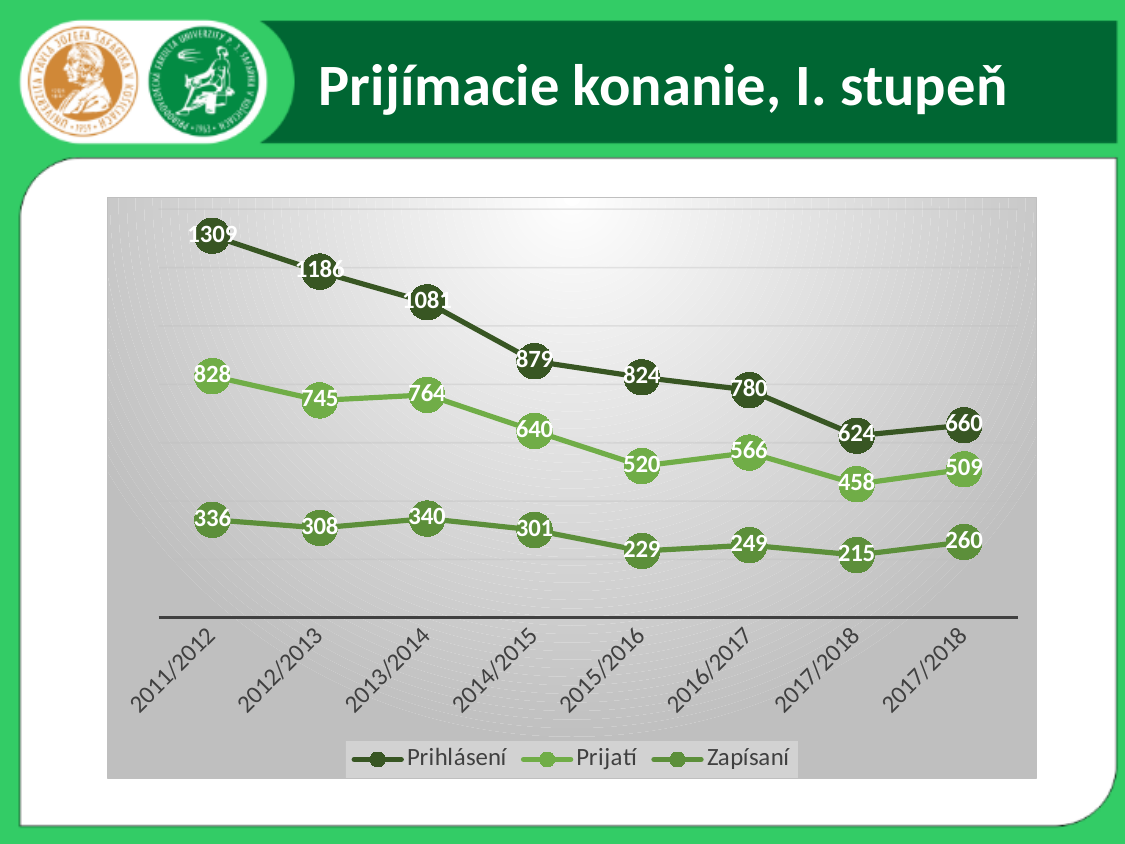
What is the difference between Prihlásení and Prijatí in 2012/2013? 441 In which year is the Prihlásení value highest? 2011/2012 How many data points does each series have? 8 How many series does the legend list? 3 Which is larger, the Prijatí value in 2013/2014 or in 2012/2013? 2013/2014 What is the value for Prihlásení in 2011/2012? 1309 What is the value for Zapísaní in 2015/2016? 229 What type of chart is shown on the slide? line chart Does the Prihlásení series generally rise or fall from 2011/2012 to 2016/2017? fall What is the value for Prijatí in 2014/2015? 640 What is the title of the slide? Prijímacie konanie, I. stupeň In which year is the Zapísaní value lowest? 2017/2018